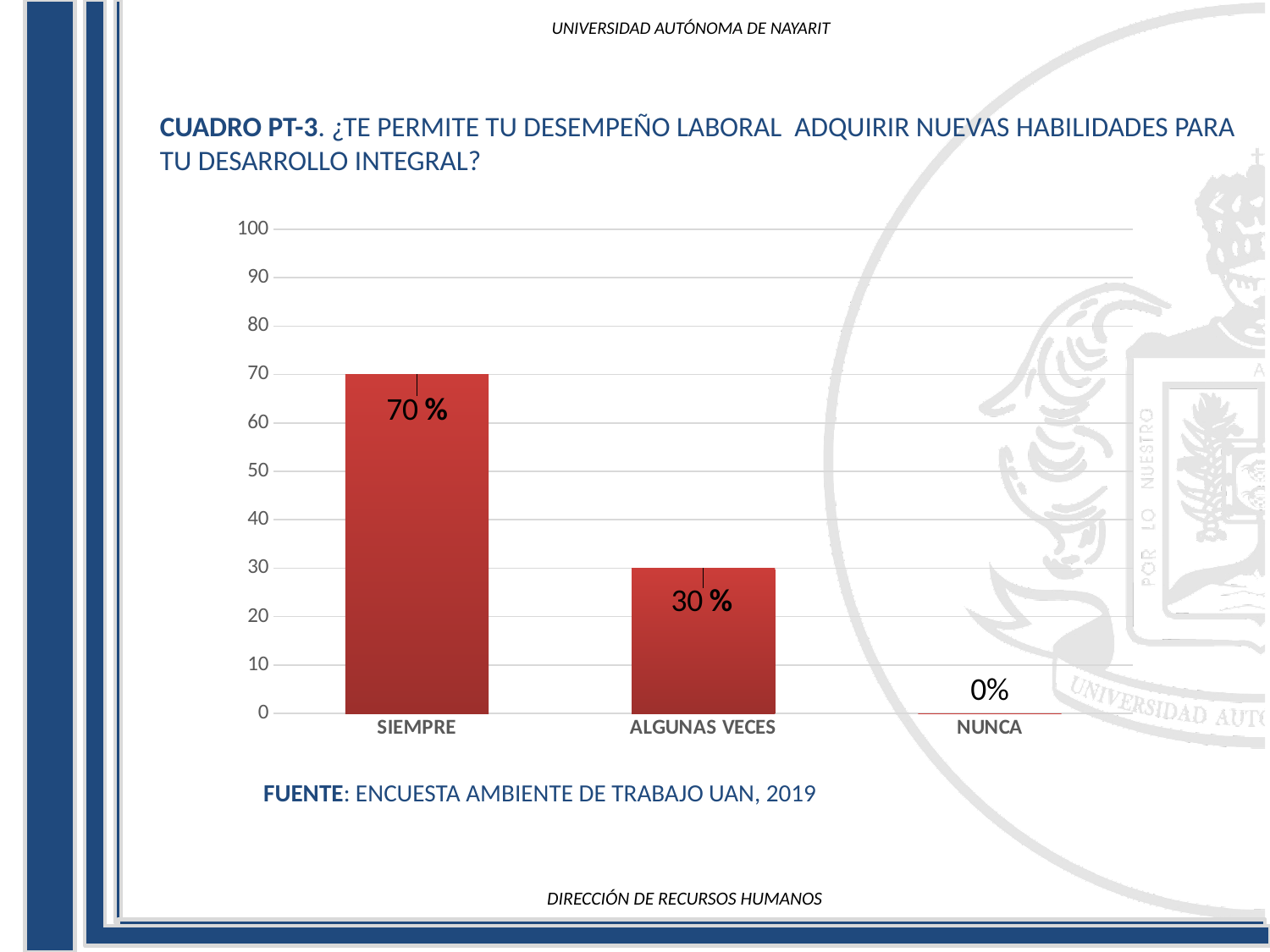
Which category has the highest value? SIEMPRE What is the difference between the values for SIEMPRE and ALGUNAS VECES? 40 % Is the value for ALGUNAS VECES greater or less than 50? less What kind of chart is shown on the slide? bar chart What is the value for ALGUNAS VECES? 30 % What is the source cited below the chart? ENCUESTA AMBIENTE DE TRABAJO UAN, 2019 Do the values rise or fall from left to right along the x axis? fall Which category has the lowest value? NUNCA What is the value for SIEMPRE? 70 % What is the value for NUNCA? 0% Which is larger, the value for SIEMPRE or the value for ALGUNAS VECES? SIEMPRE How many categories are shown on the x axis? 3